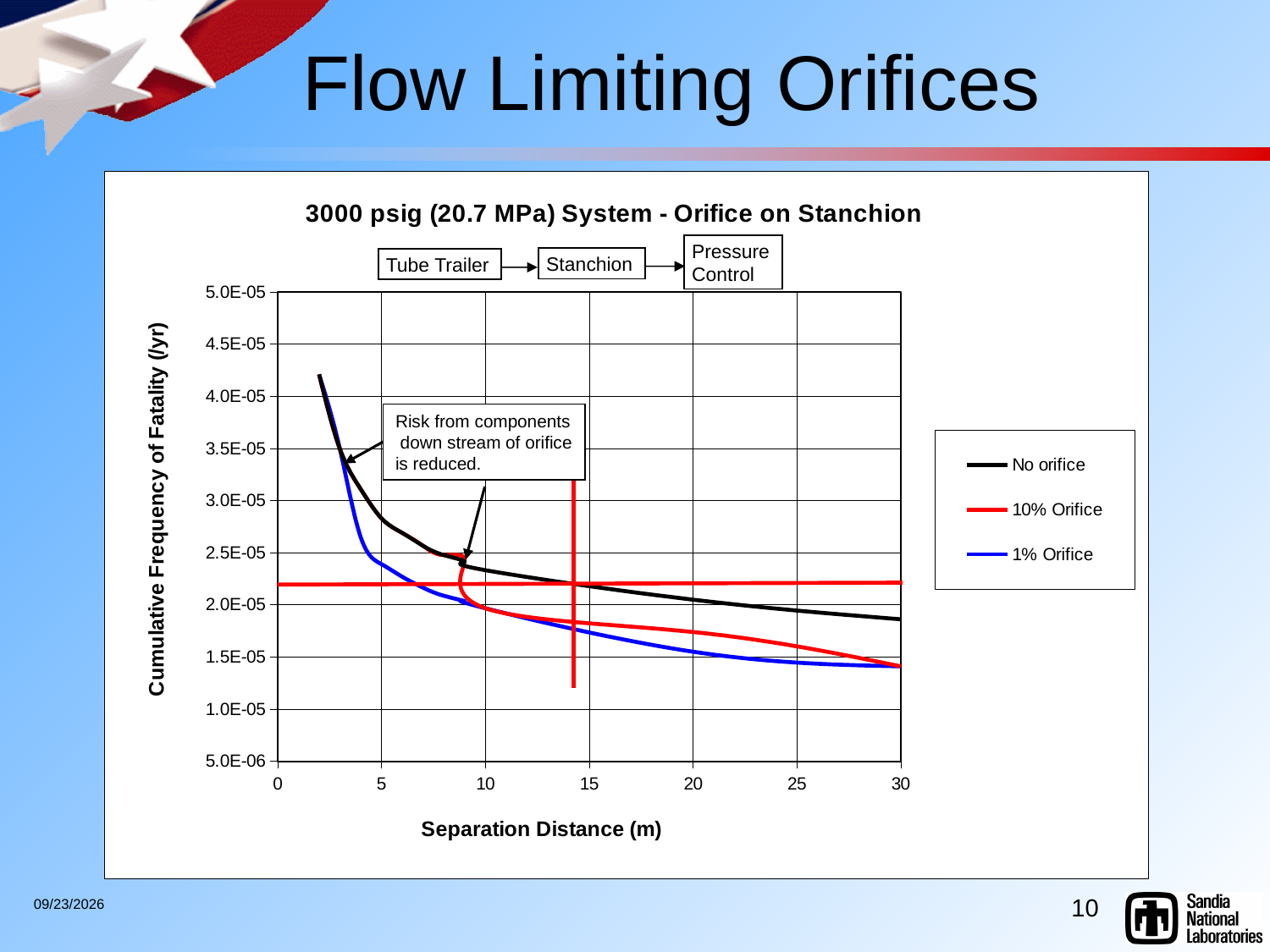
At a separation distance of 20 m, which curve is higher: No orifice or 1% Orifice? No orifice Does the 1% Orifice curve rise or fall as separation distance increases? fall Is the value of the No orifice curve at 30 m greater or less than 1.5E-05? greater Does the No orifice curve rise or fall as separation distance increases? fall What is the label of the x axis of the chart? Separation Distance (m) What kind of chart is shown on the slide? line chart Is the value of the 1% Orifice curve at 30 m greater or less than 1.5E-05? less Is the value of the No orifice curve at 15 m greater or less than 2.0E-05? greater How many series does the chart legend list? 3 What is the title of the chart? 3000 psig (20.7 MPa) System - Orifice on Stanchion At a separation distance of 30 m, which curve is higher: No orifice or 1% Orifice? No orifice